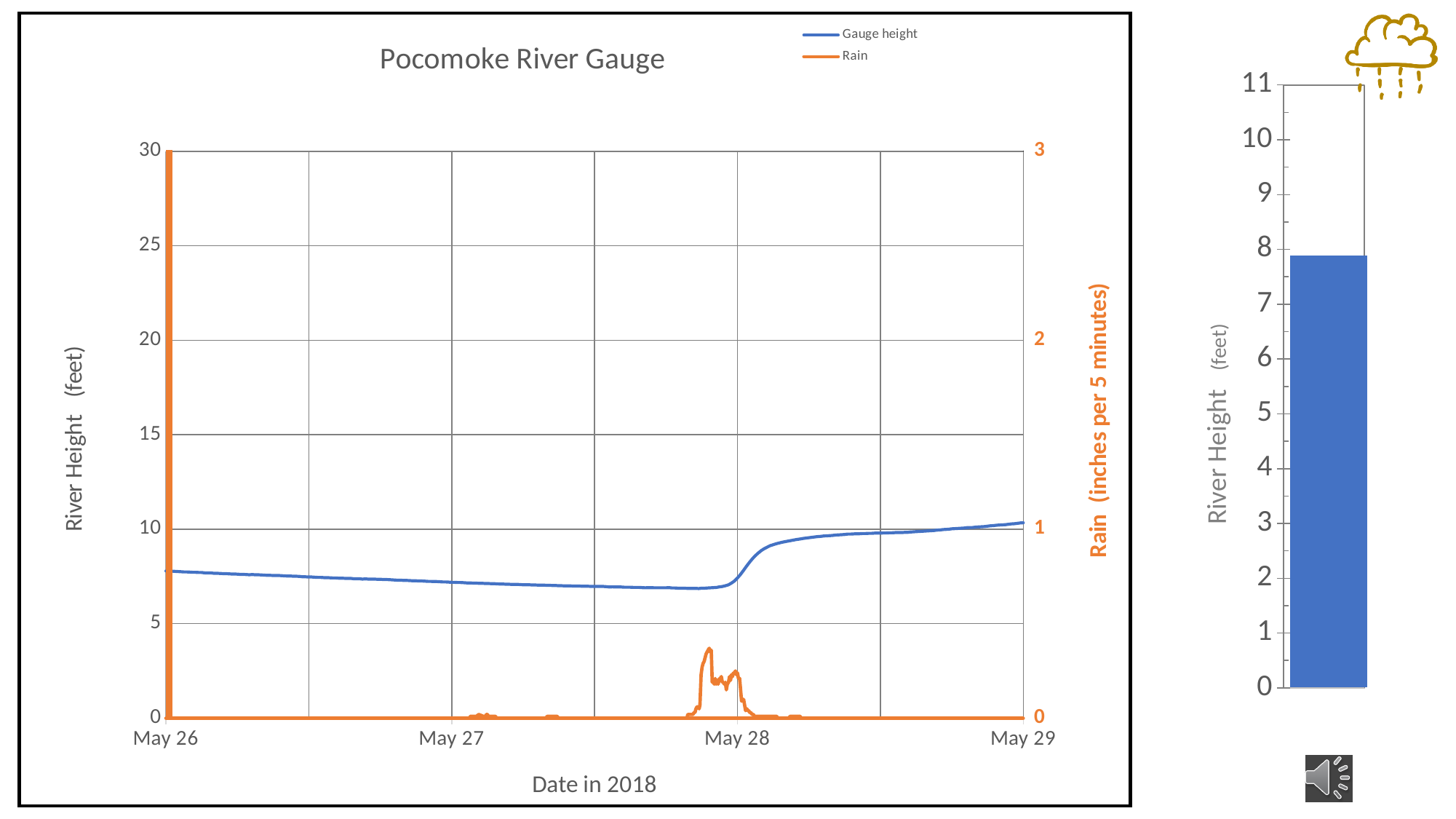
In the Pocomoke River Gauge chart, does the Gauge height rise or fall between May 28 and May 29? rise In the Pocomoke River Gauge chart, what is the label of the right-hand vertical axis? Rain (inches per 5 minutes) What are the two series named in the legend of the Pocomoke River Gauge chart? Gauge height and Rain In the Pocomoke River Gauge chart, is the peak Rain value around May 28 greater or less than 1 inch per 5 minutes? less In the River Height bar chart on the right side of the slide, is the bar's value greater or less than 10 feet? less How many dates are labelled on the x axis of the Pocomoke River Gauge chart? 4 In the Pocomoke River Gauge chart, is the Gauge height value on May 26 greater or less than 10 feet? less What kind of chart is the Pocomoke River Gauge chart? line chart How many series does the legend of the Pocomoke River Gauge chart list? 2 What kind of chart is the River Height chart on the right side of the slide? bar chart In the Pocomoke River Gauge chart, does the Gauge height rise or fall between May 26 and May 27? fall